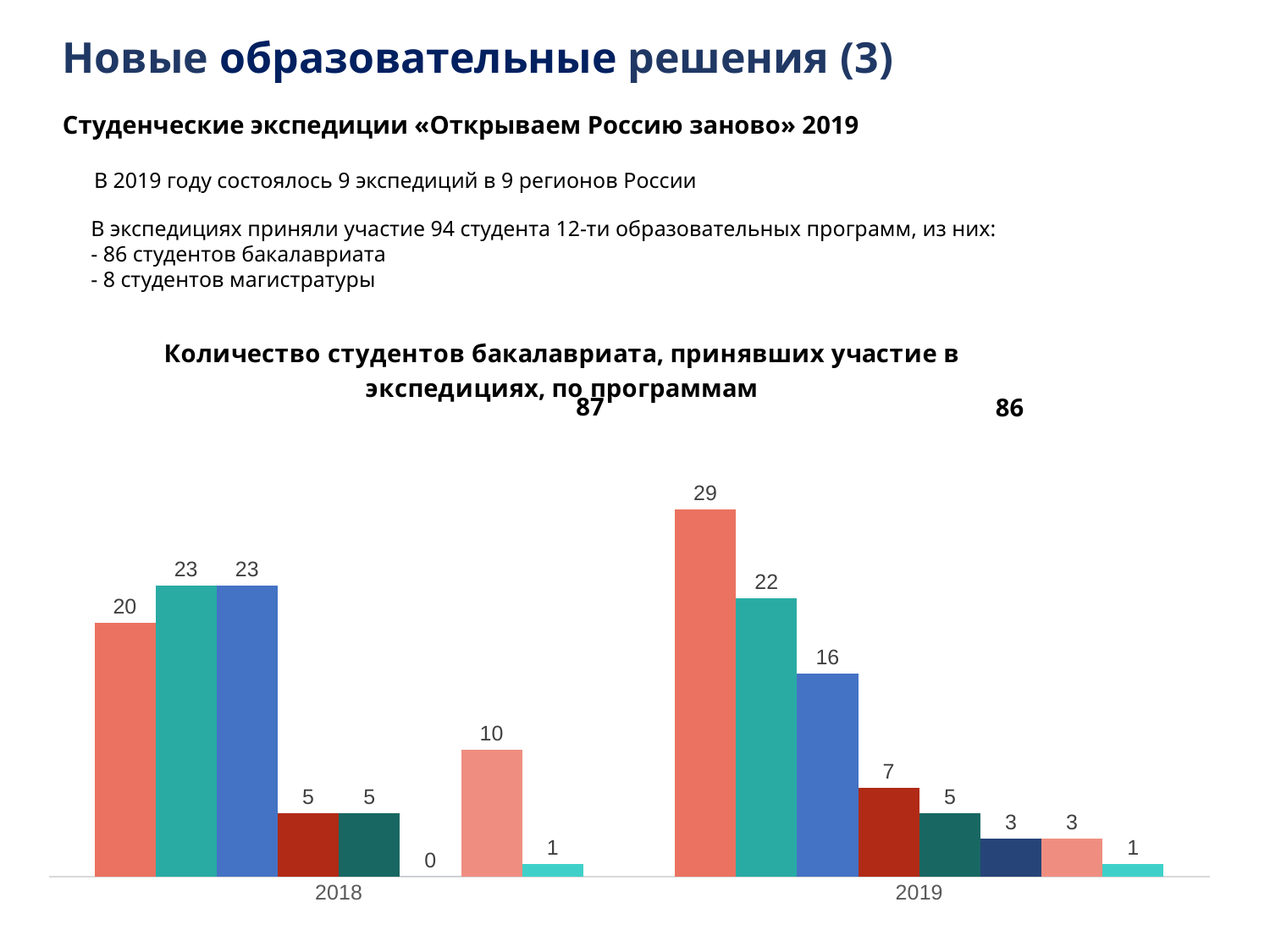
What is the difference between the first (salmon) bar in 2019 and the first (salmon) bar in 2018? 9 What is the value of the first (leftmost, salmon-coloured) bar in the 2018 group? 20 What kind of chart is shown on the slide? bar chart What is the total printed above the 2018 group? 87 How many bars are in the 2019 group? 8 How many year categories are shown on the x axis of the chart? 2 What is the title of the chart? Количество студентов бакалавриата, принявших участие в экспедициях, по программам What is the lowest value shown in the 2018 group? 0 Which is larger: the third (blue) bar in 2018 or the third (blue) bar in 2019? 2018 What is the total printed above the 2019 group? 86 What is the value of the third (blue) bar in the 2019 group? 16 What is the value of the tallest bar in the 2019 group? 29